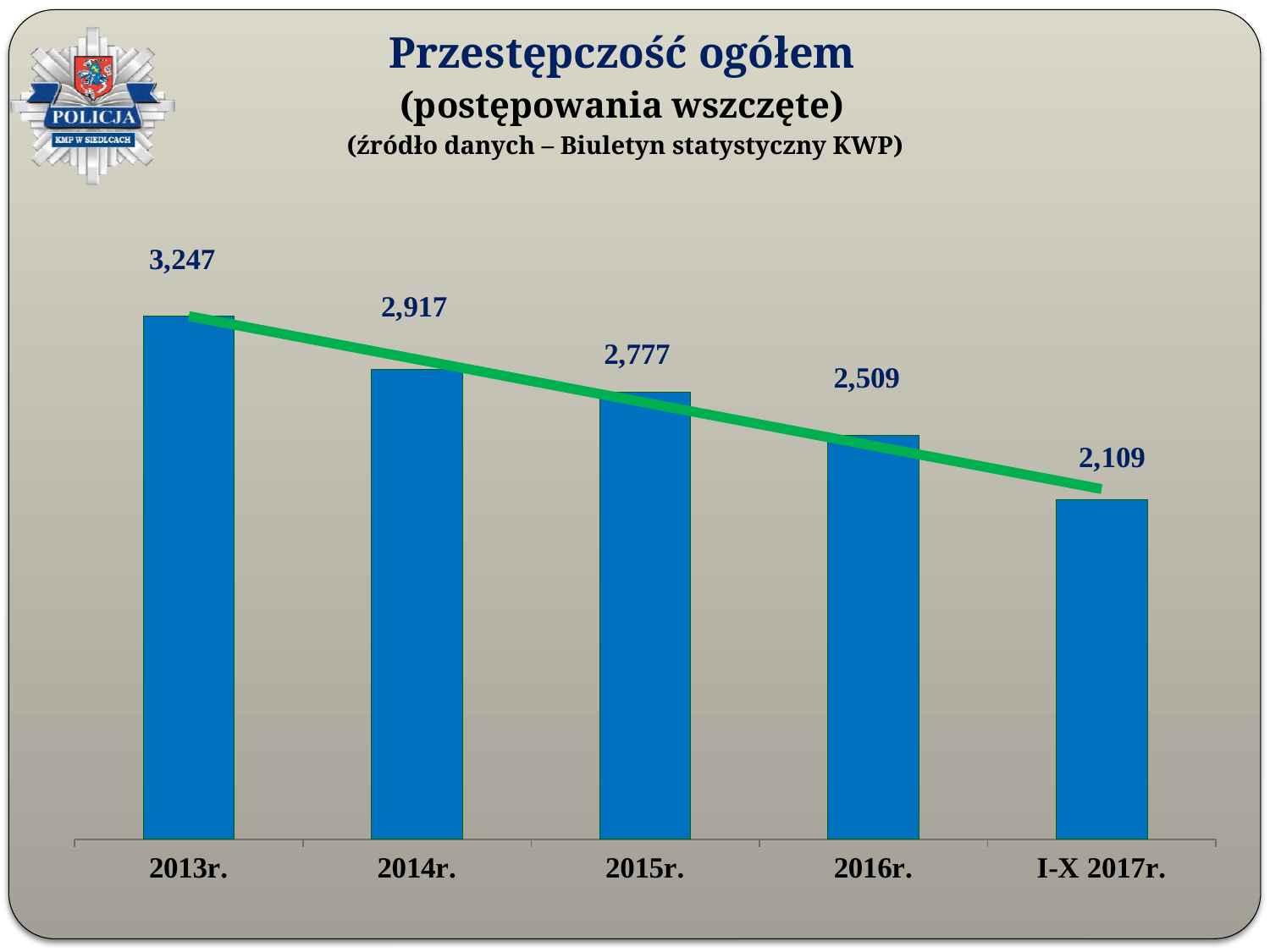
What is the value for 2014r.? 2,917 What is the value for I-X 2017r.? 2,109 Which category has the highest value? 2013r. Do the values rise or fall from 2013r. to I-X 2017r.? fall How many categories are shown on the x axis? 5 Which is larger, the value for 2015r. or the value for 2016r.? 2015r. What is the main title of the chart? Przestępczość ogółem What is the value for 2016r.? 2,509 Which category has the lowest value? I-X 2017r. What is the difference between the values for 2013r. and 2014r.? 330 What is the difference between the values for 2015r. and 2016r.? 268 What kind of chart is this? bar chart